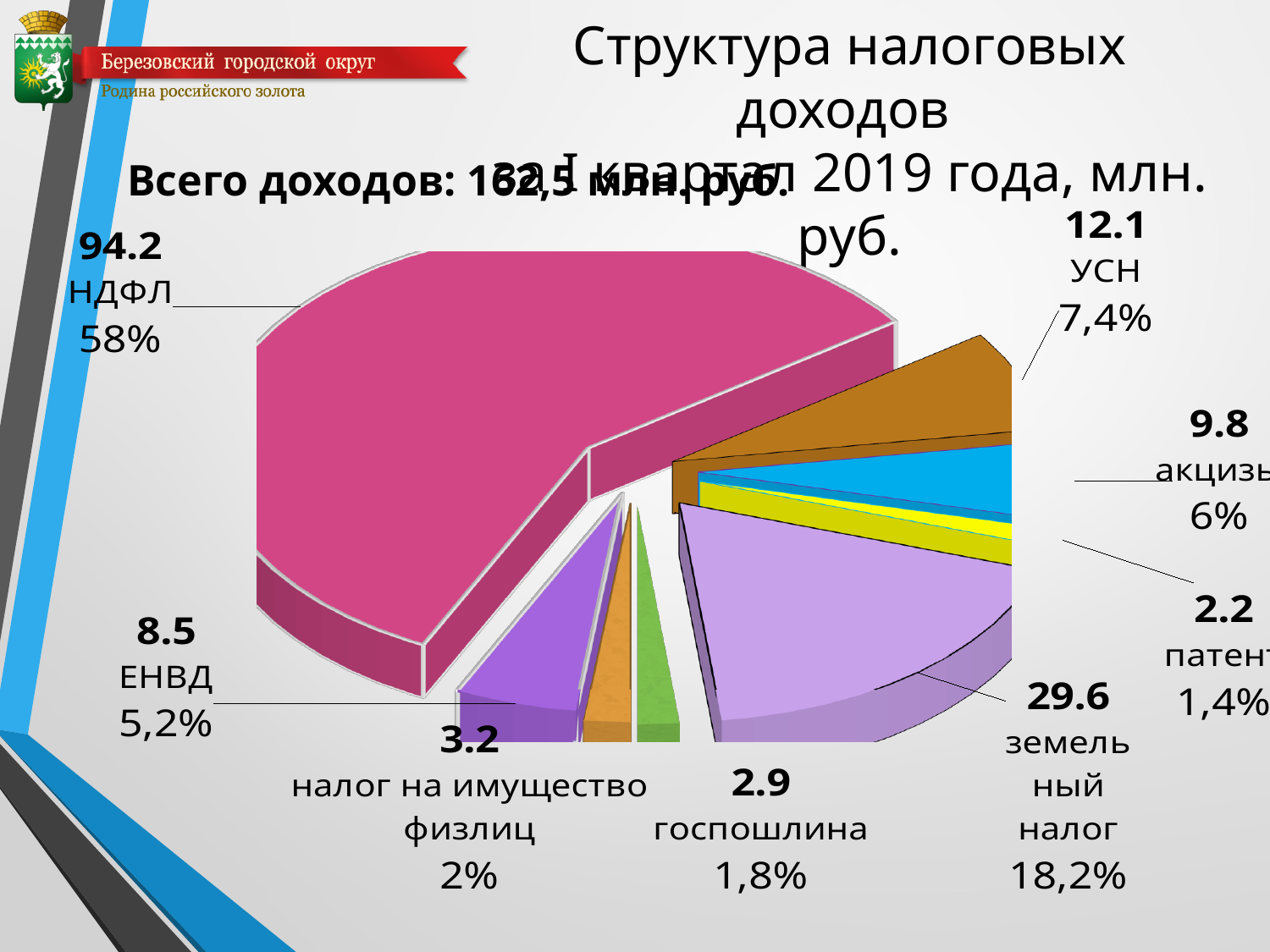
What share of the pie does патент represent? 1,4% Which category has the largest slice of the pie? НДФЛ What kind of chart is shown on the slide? pie chart How many categories are shown in the pie chart? 8 Which category has the smallest slice of the pie? патент Which is larger, the value for ЕНВД or the value for акцизы? акцизы What is the value for НДФЛ? 94.2 What is the value for земельный налог? 29.6 What is the value for УСН? 12.1 What is the difference between the values for НДФЛ and земельный налог? 64.6 What share of the pie does земельный налог represent? 18,2% What share of the pie does НДФЛ represent? 58%